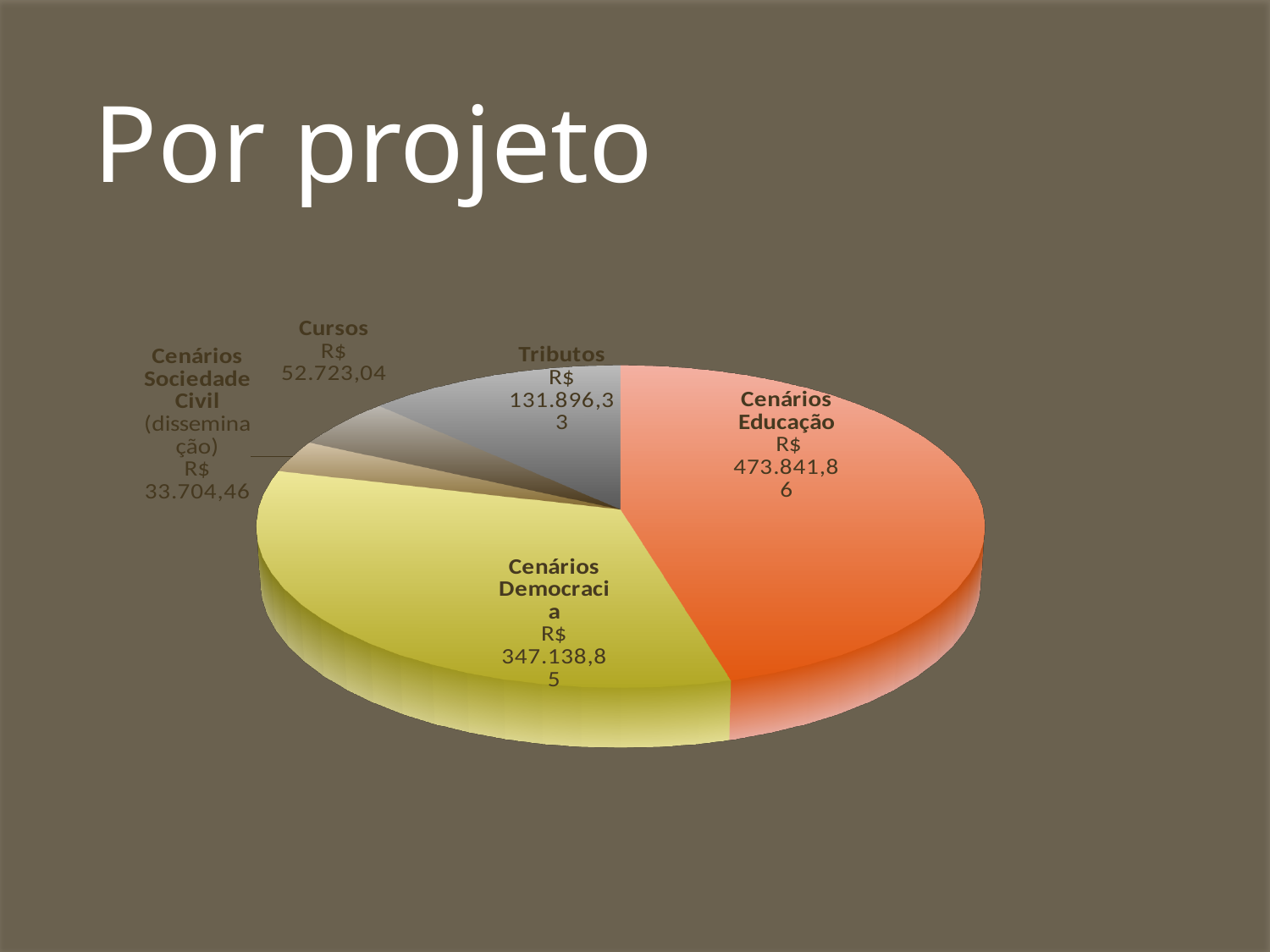
Which is larger, the value for Tributos or the value for Cursos? Tributos What is the value shown for Cenários Sociedade Civil (disseminação)? R$ 33.704,46 What is the difference between the values for Cenários Educação and Cenários Democracia? R$ 126.703,01 What is the value shown for Cenários Democracia? R$ 347.138,85 How many slices does the pie chart have? 5 What type of chart is shown on the slide? Pie chart What is the value shown for Cenários Educação? R$ 473.841,86 What is the value shown for Tributos? R$ 131.896,33 What is the title of the slide containing the pie chart? Por projeto Which project has the largest slice of the pie? Cenários Educação What is the value shown for Cursos? R$ 52.723,04 Which project has the smallest slice of the pie? Cenários Sociedade Civil (disseminação)